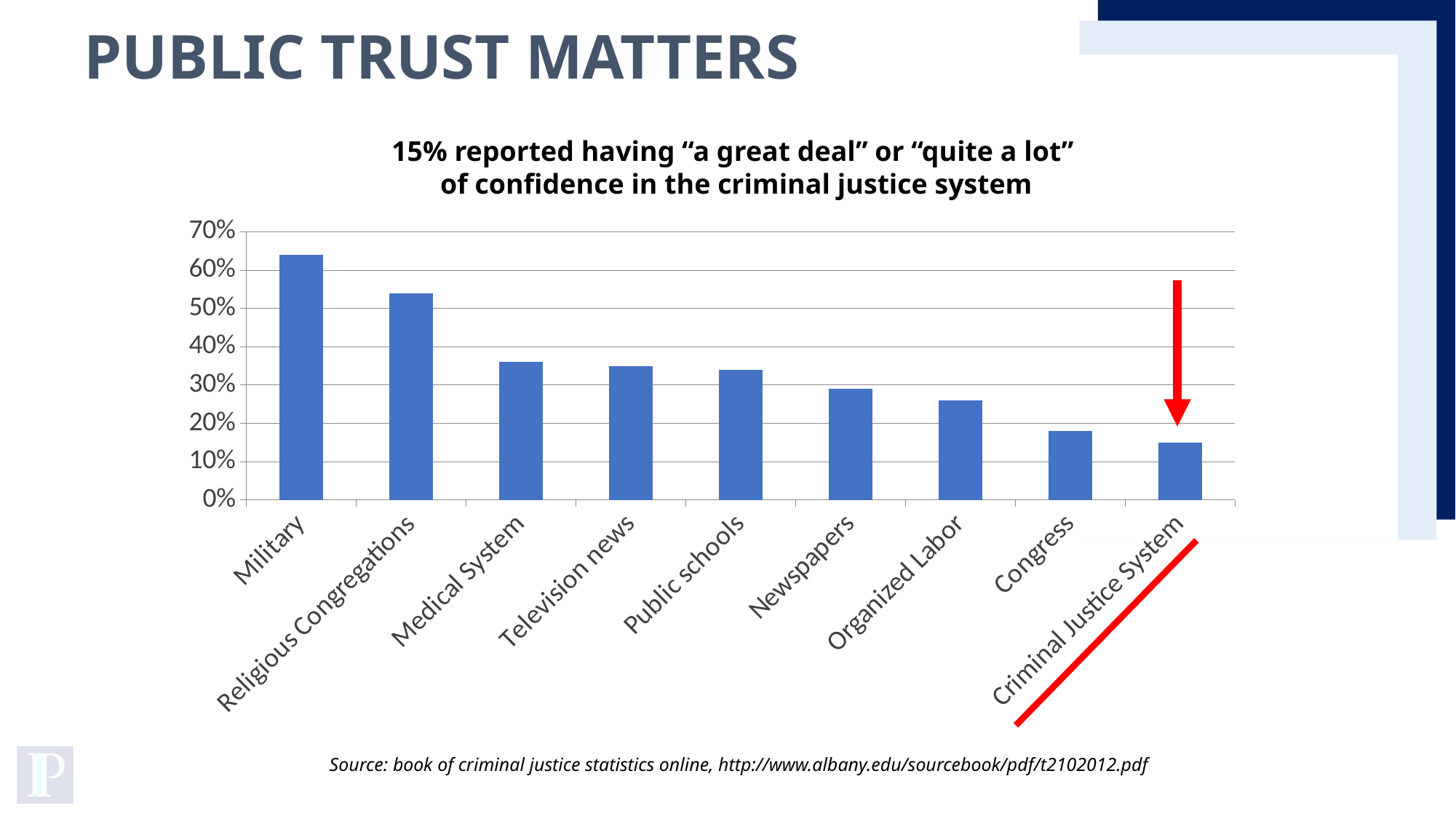
How many categories are shown on the x axis of the chart? 9 Which has a higher value, Military or Religious Congregations? Military Is the value for Organized Labor greater or less than 30%? less What percentage reported having confidence in the Criminal Justice System, according to the chart title? 15% Is the value for Military greater or less than 60%? greater Which category has the highest value in the chart? Military Which category has the lowest value in the chart? Criminal Justice System Is the value for Congress greater or less than 20%? less What kind of chart is shown on the slide? bar chart Which category does the red arrow on the chart point to? Criminal Justice System Do the values rise or fall moving from left to right along the x axis? fall